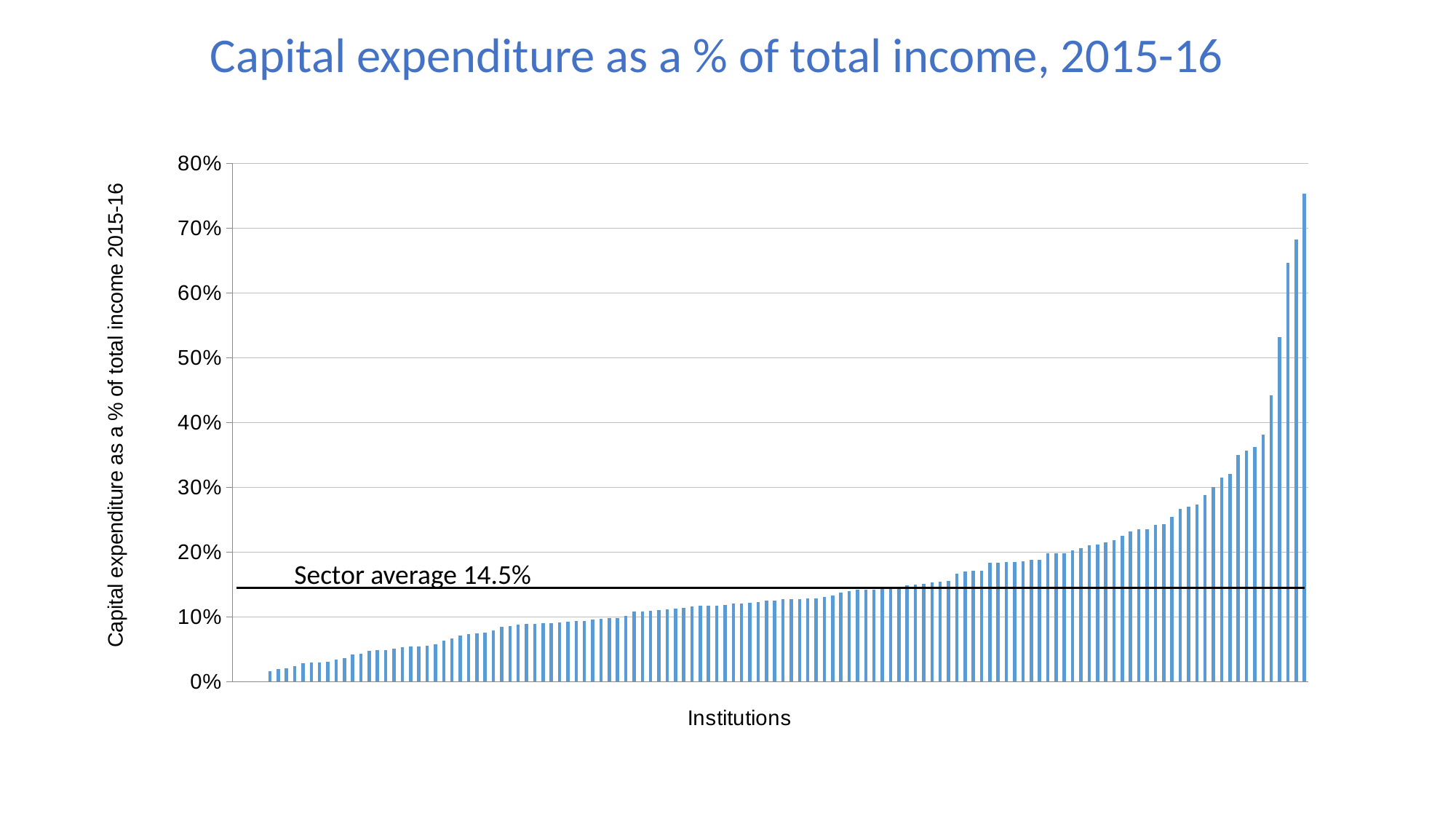
What is the title of the chart? Capital expenditure as a % of total income, 2015-16 What kind of chart is shown on the slide? Bar chart Is the sector average line above or below 20% on the y axis? below Is the value of the shortest bar greater or less than 10%? less Which bar is the highest: the leftmost bar or the rightmost bar? The rightmost bar Is the value of the tallest bar greater or less than 70%? greater What sector average value is printed on the chart? 14.5% Do the bar values rise or fall from left to right along the x axis? Rise What is the highest value shown on the y axis? 80% What is the label of the x axis? Institutions